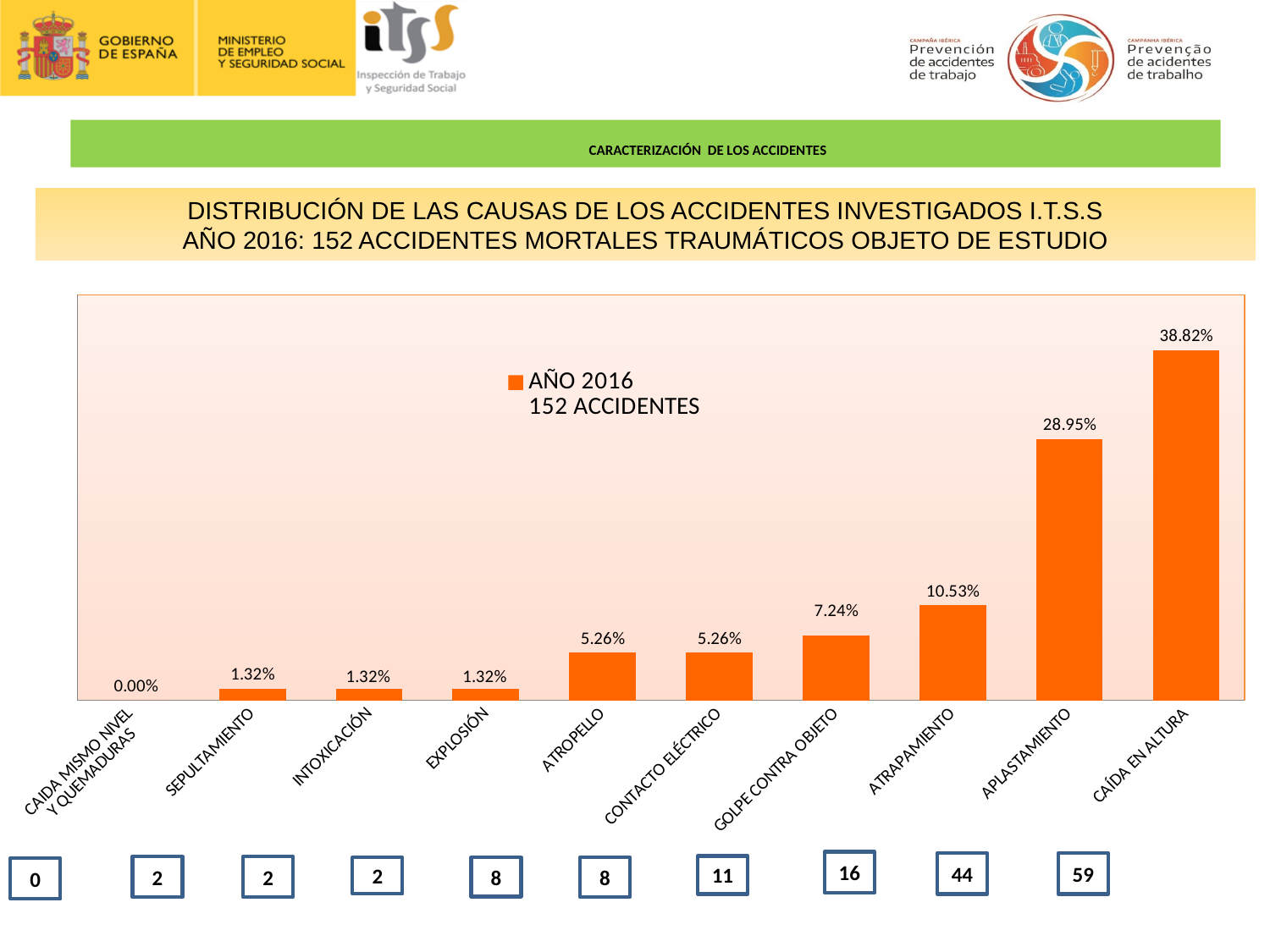
How many series does the chart legend list? 1 How many categories are shown on the x axis of the chart? 10 Which category has the highest percentage? CAÍDA EN ALTURA What type of chart is shown on the slide? Bar chart What percentage is shown for ATRAPAMIENTO? 10.53% Which category has the lowest percentage? CAIDA MISMO NIVEL Y QUEMADURAS What is the difference in percentage points between CAÍDA EN ALTURA and APLASTAMIENTO? 9.87 Which is larger, the percentage for ATRAPAMIENTO or for GOLPE CONTRA OBJETO? ATRAPAMIENTO Do the percentages rise or fall moving from left to right along the x axis? Rise What percentage is shown for CAÍDA EN ALTURA? 38.82% What percentage is shown for GOLPE CONTRA OBJETO? 7.24% What percentage is shown for APLASTAMIENTO? 28.95%